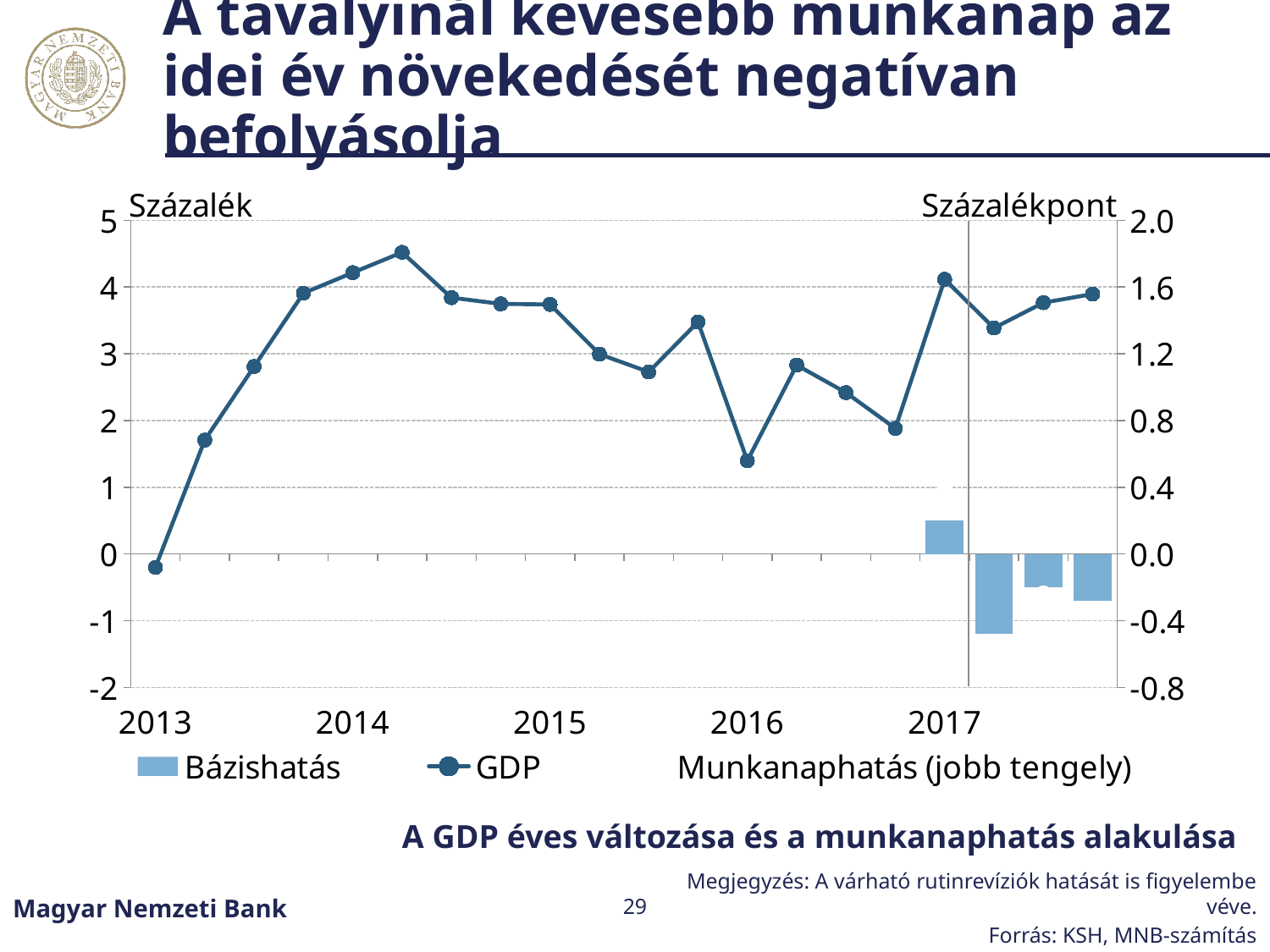
Which year contains the highest point of the GDP line? 2014 Which year contains the lowest point of the GDP line? 2013 Is the GDP value at the start of 2017 larger or smaller than the GDP value at the start of 2016? larger What is the label of the left vertical axis? Százalék Is the GDP value at the start of 2016 greater or less than 2? less How many series does the legend list? 3 Is the highest GDP value on the line greater or less than 4? greater Does the GDP line rise or fall between the start of 2013 and the start of 2014? rise What kind of chart is shown on the slide? A combined line and bar chart What is the title of the chart? A GDP éves változása és a munkanaphatás alakulása Is the GDP value at the start of 2013 greater or less than 0? less